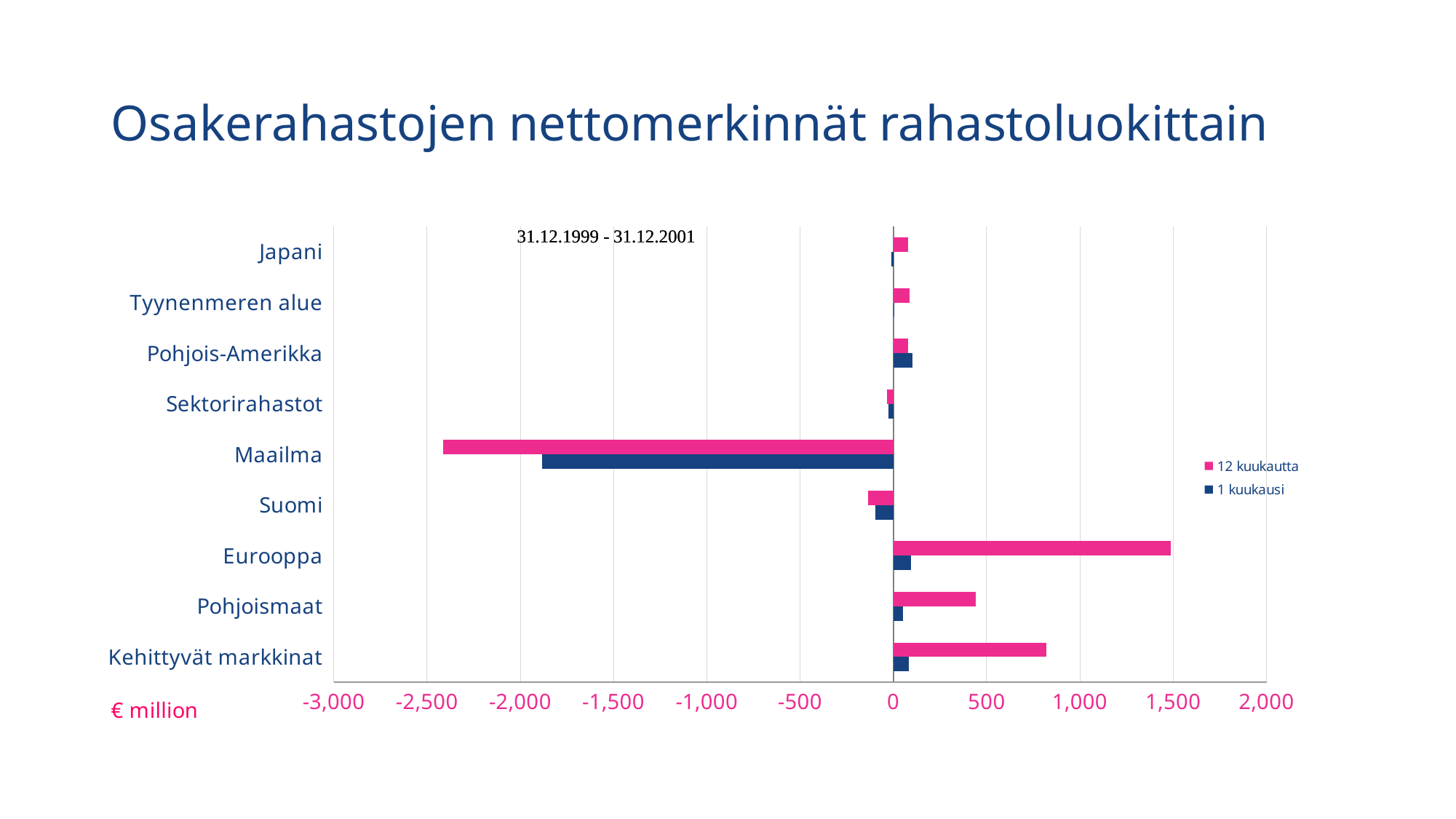
Which is larger for the 12 kuukautta series: Eurooppa or Kehittyvät markkinat? Eurooppa Which category has the lowest value for the 12 kuukautta series? Maailma What unit is shown for the values on the chart? € million Is the 1 kuukausi value for Maailma greater or less than -1,500? less Is the 12 kuukautta value for Maailma greater or less than -2,000? less How many series does the legend list? 2 Which category has the highest value for the 12 kuukautta series? Eurooppa Is the 12 kuukautta value for Eurooppa greater or less than 1,000? greater How many fund categories are listed on the chart? 9 What kind of chart is shown on the slide? bar chart Which category has the lowest value for the 1 kuukausi series? Maailma